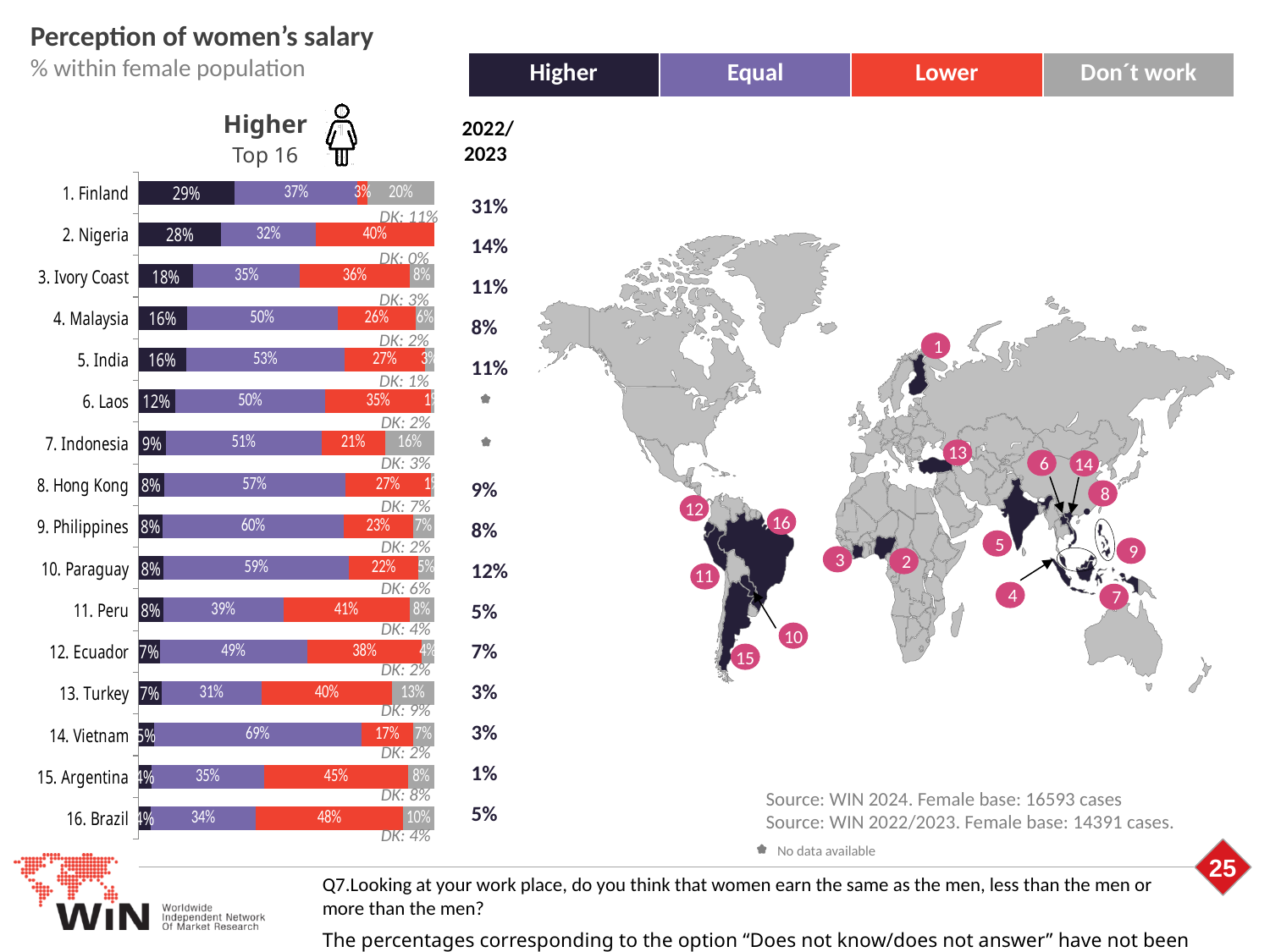
What was Finland's 'Higher' percentage in the 2022/2023 column? 31% What is the difference between the 'Lower' values for Nigeria and Finland? 37% What type of chart is used to show the perception of women's salary by country? Stacked bar chart Which is larger: the 'Equal' value for India or the 'Equal' value for Turkey? India Which country has the highest 'Equal' percentage in the bar chart? Vietnam What is the 'DK' value shown for Turkey in the bar chart? 9% How many countries are listed in the 'Higher Top 16' bar chart? 16 How many response categories does the legend list for the bar chart? 4 What is the 'Equal' value for Vietnam in the bar chart? 69% What is the 'Lower' value for Brazil in the bar chart? 48% What percentage of women in Finland say women's salary is 'Higher'? 29% Which country has the highest 'Higher' percentage in the bar chart? Finland